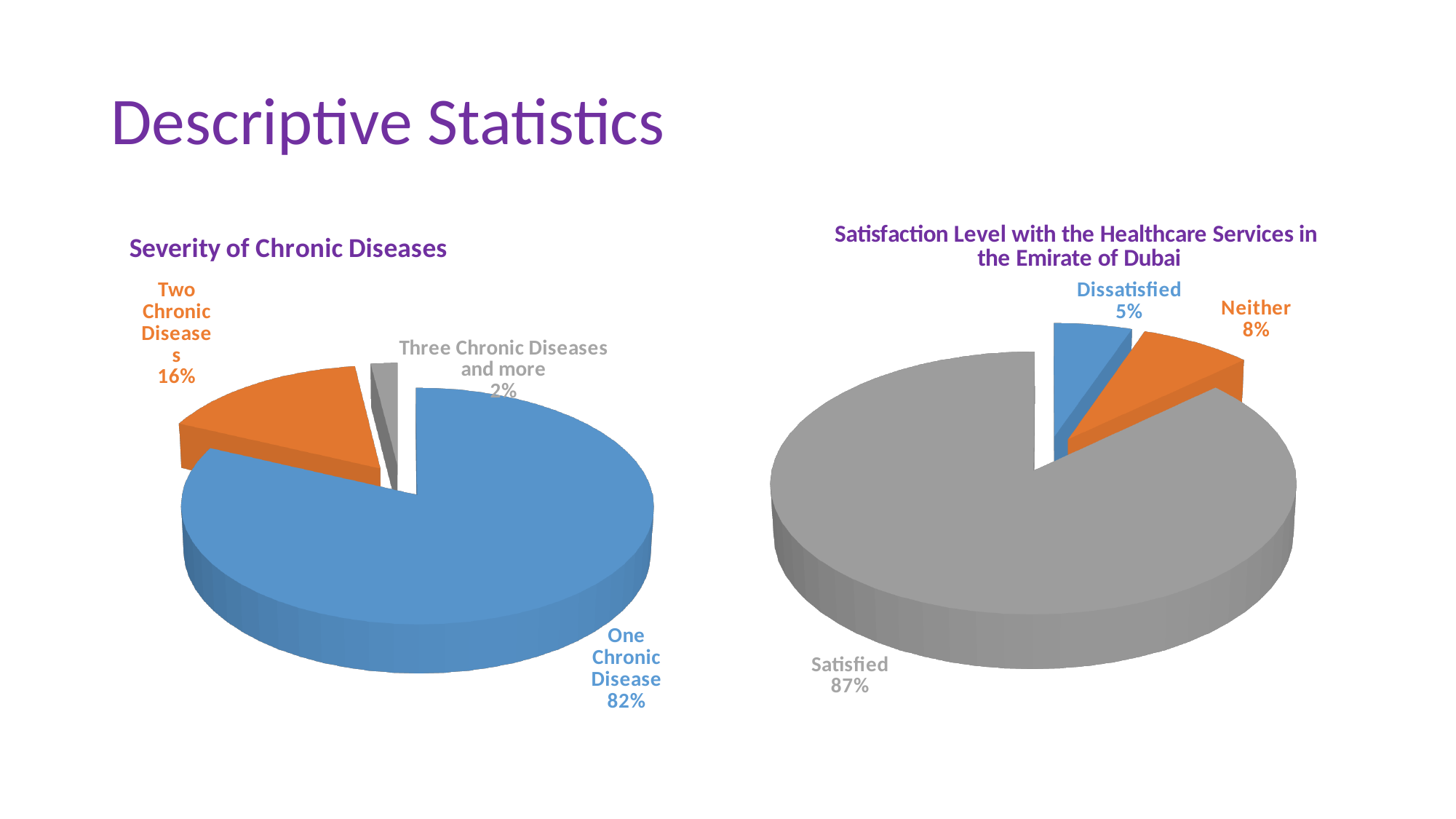
In the 'Satisfaction Level with the Healthcare Services in the Emirate of Dubai' chart, which is larger, Neither or Dissatisfied? Neither In the 'Severity of Chronic Diseases' chart, what is the difference in percentage points between One Chronic Disease and Two Chronic Diseases? 66 In the 'Severity of Chronic Diseases' chart, what share is labelled for One Chronic Disease? 82% In the 'Severity of Chronic Diseases' chart, which category has the smallest slice? Three Chronic Diseases and more In the 'Satisfaction Level with the Healthcare Services in the Emirate of Dubai' chart, what share is labelled for Satisfied? 87% In the 'Severity of Chronic Diseases' chart, what share is labelled for Two Chronic Diseases? 16% What kind of chart is the 'Satisfaction Level with the Healthcare Services in the Emirate of Dubai' chart? Pie chart In the 'Severity of Chronic Diseases' chart, how many categories are shown? 3 In the 'Severity of Chronic Diseases' chart, which category has the largest slice? One Chronic Disease In the 'Satisfaction Level with the Healthcare Services in the Emirate of Dubai' chart, what colour is the Satisfied slice? Grey